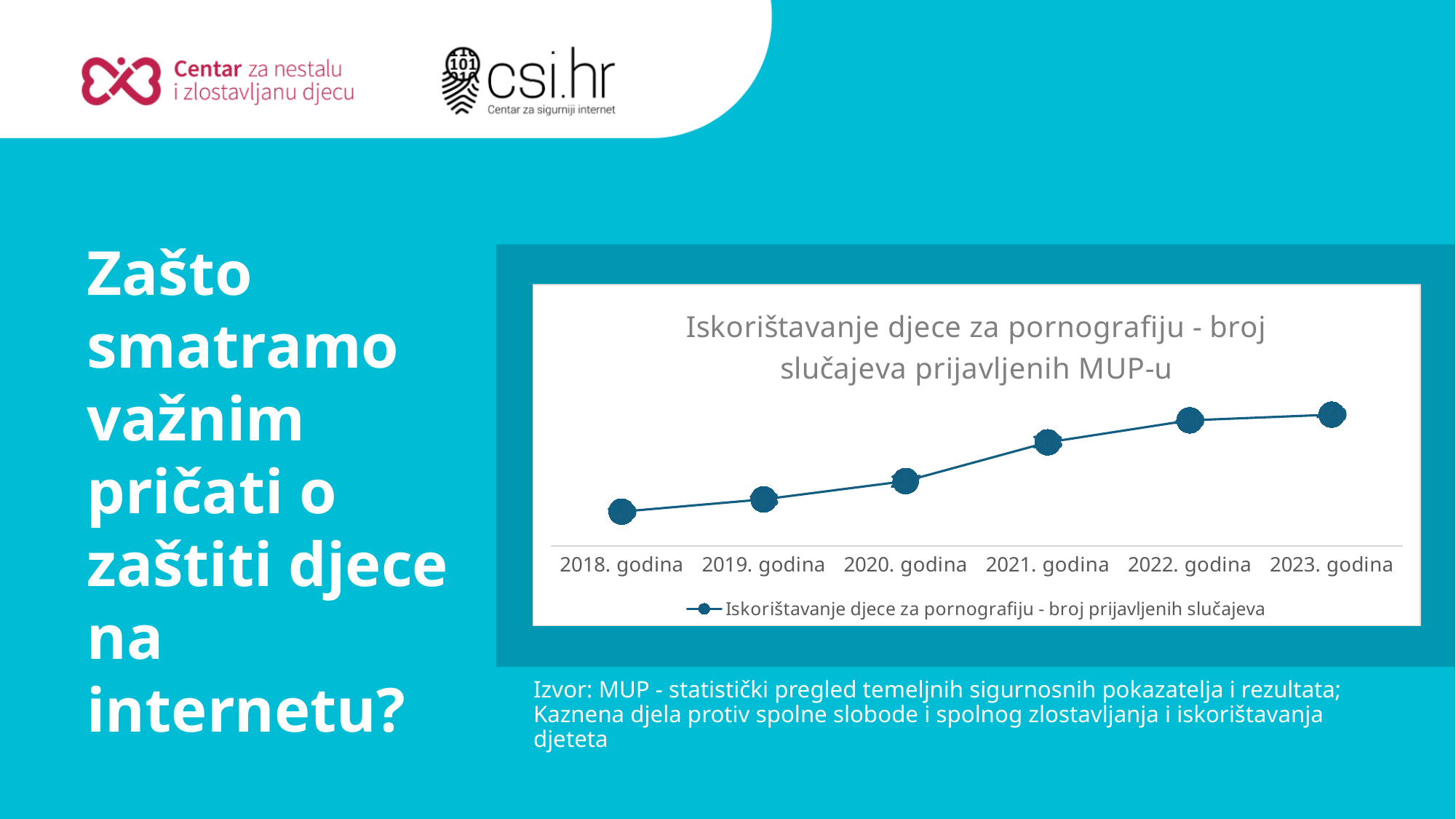
What is the title of the chart? Iskorištavanje djece za pornografiju - broj slučajeva prijavljenih MUP-u What kind of chart is shown on the slide? line chart Which is larger, the value for 2018. godina or the value for 2020. godina? 2020. godina What is the legend entry of the series in the chart? Iskorištavanje djece za pornografiju - broj prijavljenih slučajeva Which is larger, the value for 2021. godina or the value for 2019. godina? 2021. godina How many years are plotted on the x axis of the chart? 6 What is the first year shown on the x axis of the chart? 2018. godina Which is larger, the value for 2022. godina or the value for 2020. godina? 2022. godina How many series does the chart legend list? 1 Do the values in the chart rise or fall from 2018. godina to 2023. godina? rise Which year has the lowest value in the chart? 2018. godina